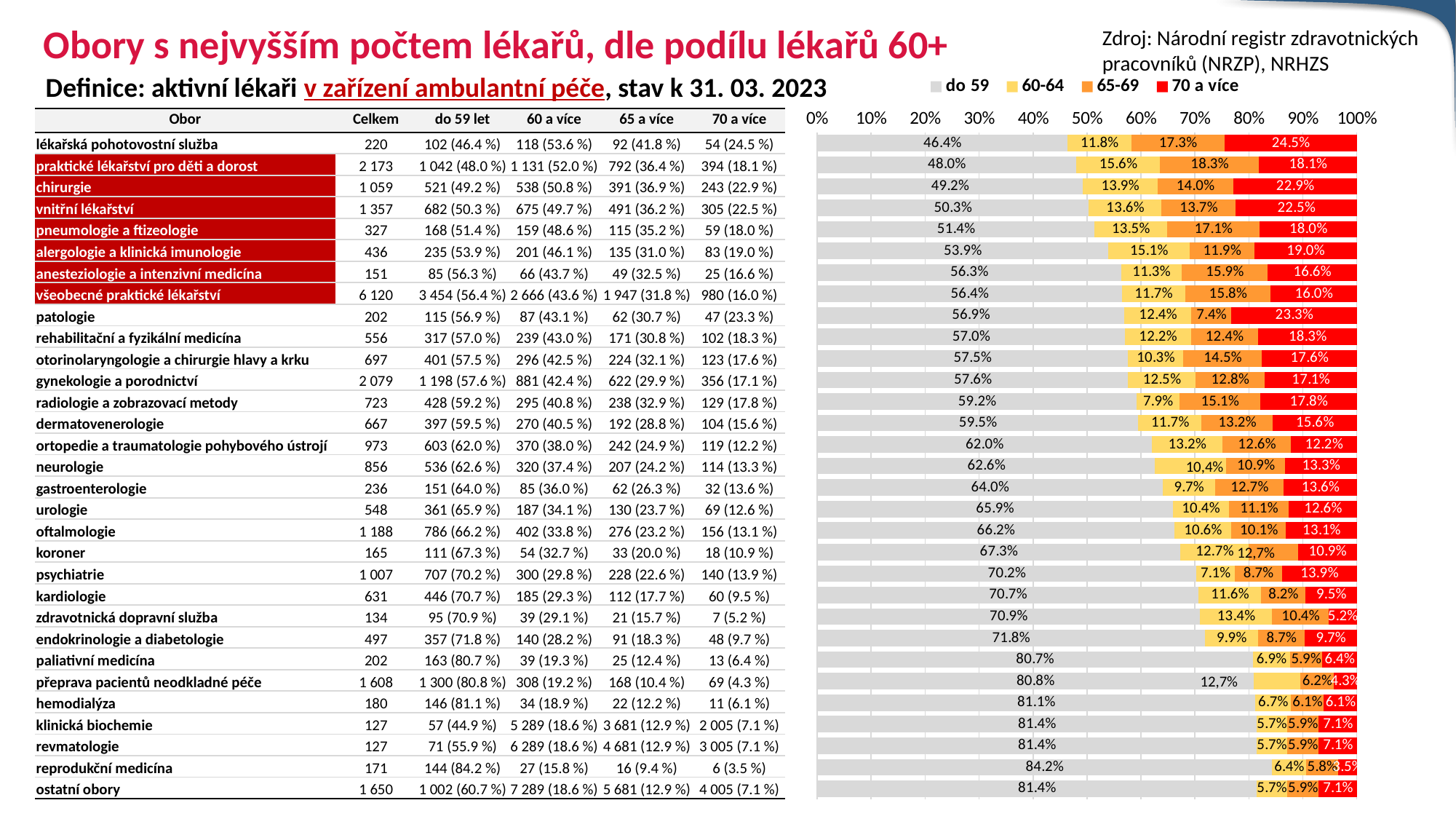
In the chart, is the 'do 59' share for psychiatrie greater or less than 60%? greater Which row in the chart has the smallest 'do 59' segment? lékařská pohotovostní služba Which row in the chart has the largest 'do 59' segment? reprodukční medicína How many series does the chart legend list? 4 What colour does the chart legend use for the '70 a více' series? red In the chart, what is the '60-64' share shown on the bar for vnitřní lékařství? 13.6% In the chart, which has the larger '65-69' segment: lékařská pohotovostní služba or praktické lékařství pro děti a dorost? praktické lékařství pro děti a dorost In the chart, what is the '70 a více' share shown on the bar for chirurgie? 22.9% How many bars does the chart contain? 31 In the chart, how much larger is the '70 a více' share for lékařská pohotovostní služba (24.5%) than for chirurgie (22.9%)? 1.6 percentage points In the chart, what is the 'do 59' share shown on the top bar (lékařská pohotovostní služba)? 46.4% What kind of chart is shown on the right side of the slide? stacked bar chart